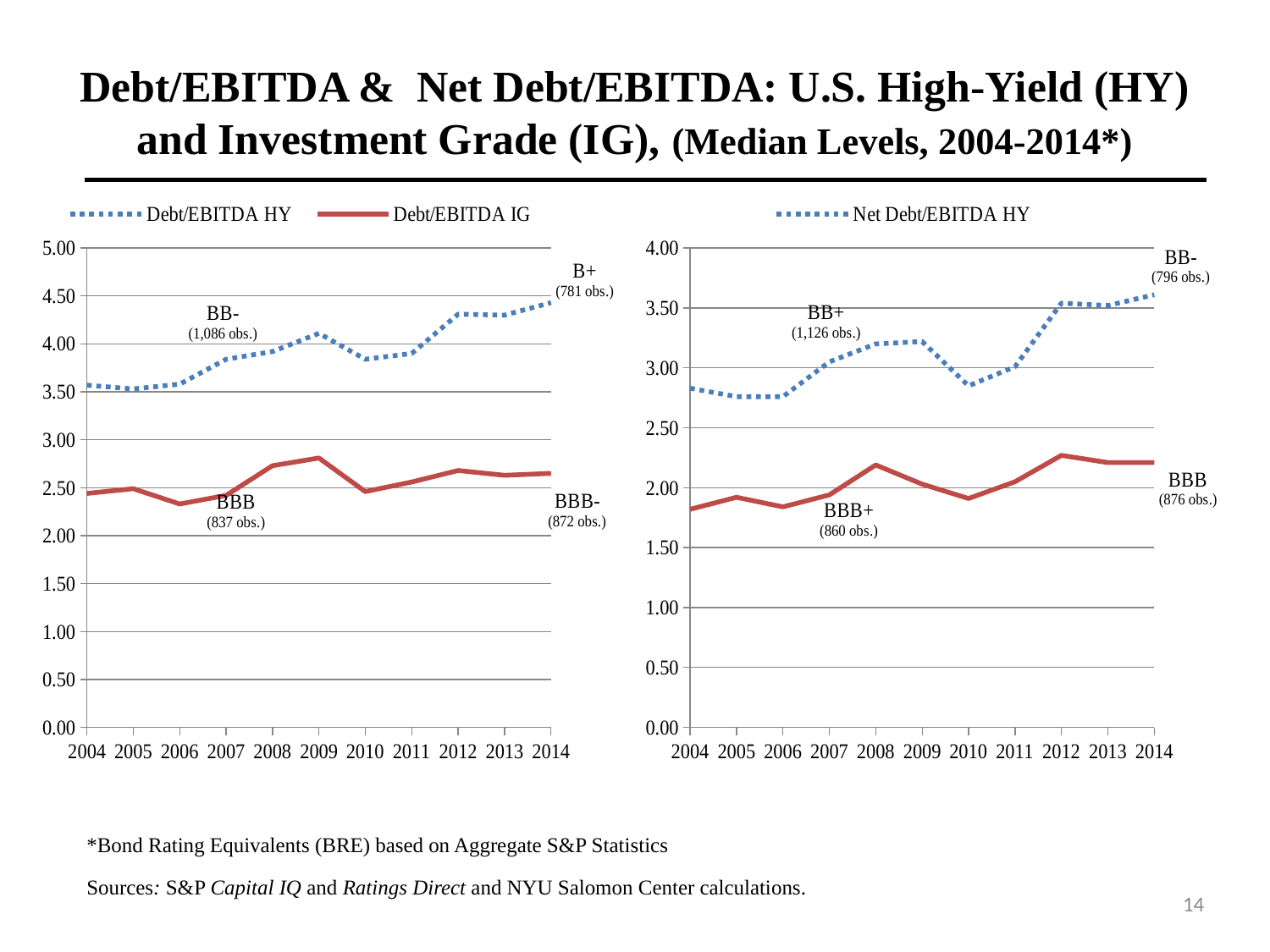
In the left chart, does the Debt/EBITDA HY line overall rise or fall from 2004 to 2014? Rise In the right chart, is the Net Debt/EBITDA HY value for 2004 greater or less than 3.00? less In the left chart, is the Debt/EBITDA HY value for 2014 greater or less than 4.00? greater In the left chart, is the Debt/EBITDA IG value for 2006 greater or less than 2.50? less In the right chart, how many observations are noted next to the BB- label at the end of the HY line? 796 obs. How many series does the legend of the left chart list? 2 In the left chart, which series has the larger value in 2014, Debt/EBITDA HY or Debt/EBITDA IG? Debt/EBITDA HY In the left chart, which year has the lowest Debt/EBITDA IG value? 2006 In the left chart, which year has the highest Debt/EBITDA HY value? 2014 What type of chart is the left chart (Debt/EBITDA)? Line chart How many years are shown on the x axis of the right chart (Net Debt/EBITDA)? 11